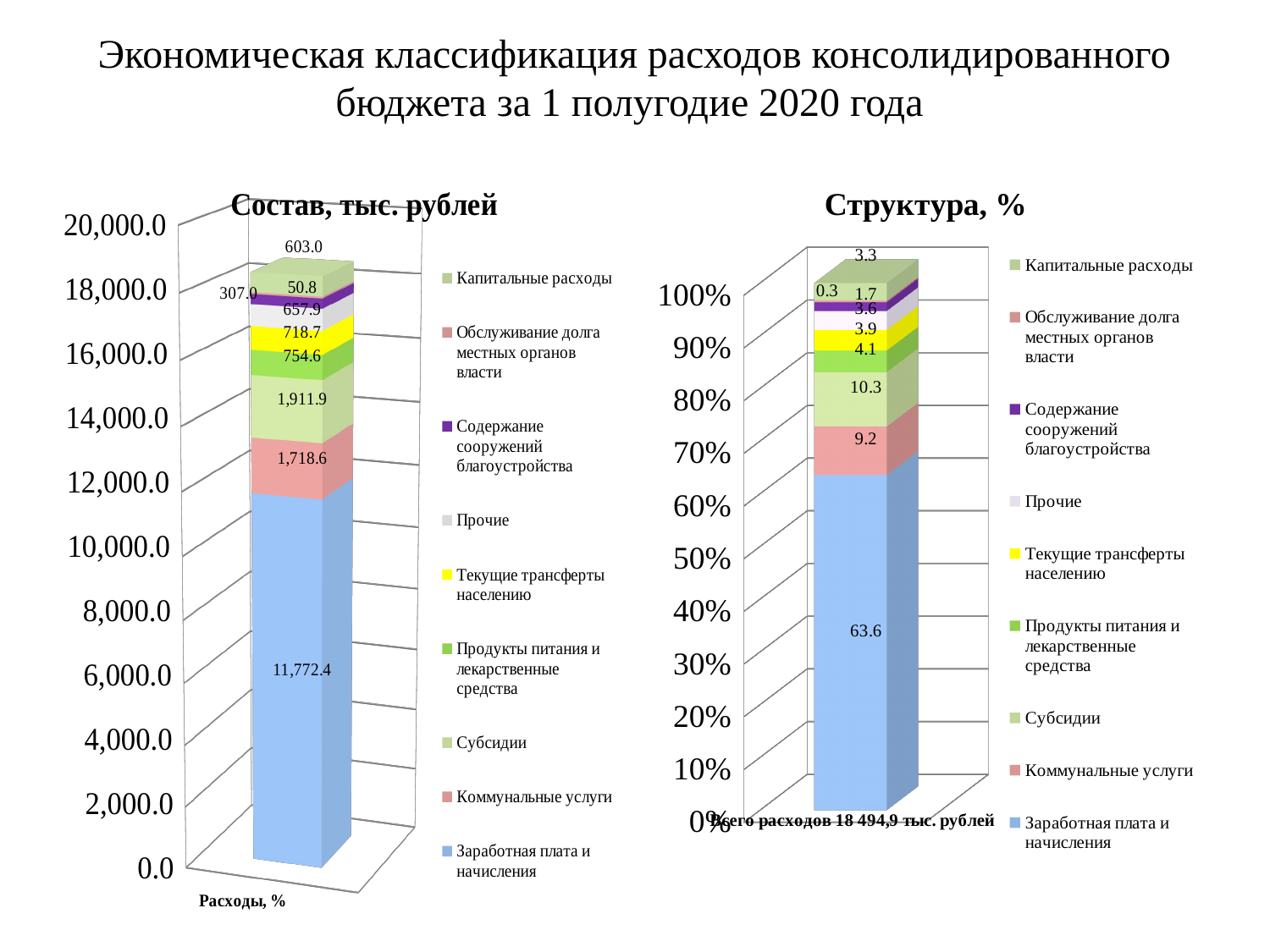
In the chart titled "Структура, %", what is the value for Обслуживание долга местных органов власти? 0.3 In the chart titled "Состав, тыс. рублей", which series has the smallest value? Обслуживание долга местных органов власти What kind of chart is the chart titled "Состав, тыс. рублей"? Stacked bar chart In the chart titled "Состав, тыс. рублей", what is the value for Заработная плата и начисления? 11,772.4 In the chart titled "Структура, %", what is the value for Коммунальные услуги? 9.2 In the chart titled "Структура, %", which is larger: Продукты питания и лекарственные средства or Текущие трансферты населению? Продукты питания и лекарственные средства How many series does the legend of the chart titled "Структура, %" list? 9 According to the text below the chart titled "Структура, %", what is the total of all expenditures? 18 494,9 тыс. рублей In the chart titled "Состав, тыс. рублей", which series has the largest value? Заработная плата и начисления In the chart titled "Состав, тыс. рублей", what is the value for Субсидии? 1,911.9 In the chart titled "Состав, тыс. рублей", what is the difference between Субсидии and Коммунальные услуги? 193.3 In the chart titled "Состав, тыс. рублей", what is the value for Капитальные расходы? 603.0